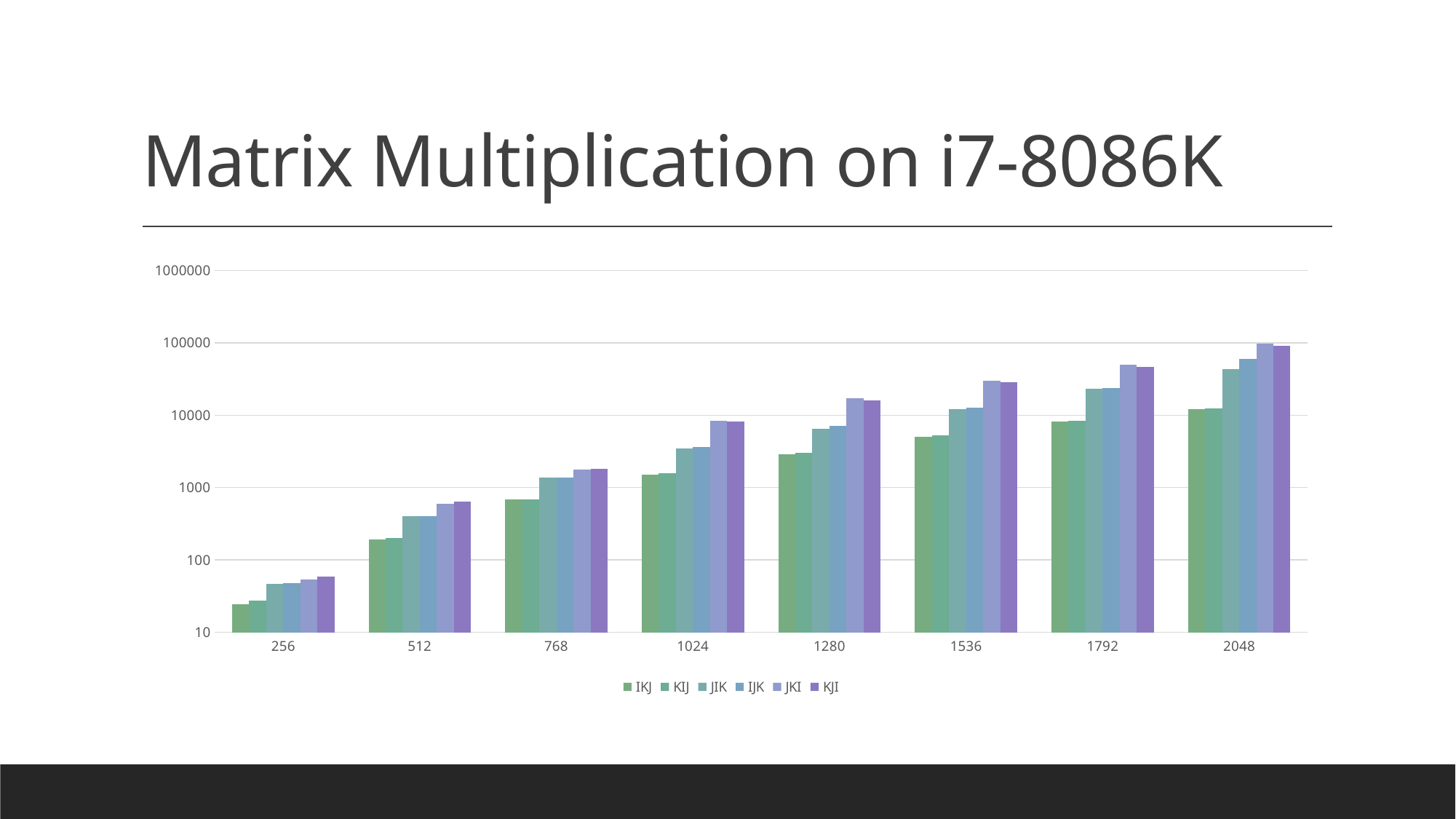
Do the values for the IKJ series rise or fall as the matrix size increases along the x axis? rise What kind of chart is shown on the slide? bar chart Is the value for JKI at matrix size 1536 greater or less than 10000? greater Is the value for IKJ at matrix size 256 greater or less than 100? less Which matrix size category has the highest bars overall? 2048 What is the title of the slide containing the chart? Matrix Multiplication on i7-8086K Is the value for IKJ at matrix size 2048 greater or less than 10000? greater Which series is listed first in the legend? IKJ At matrix size 2048, which is larger, the value for JKI or the value for IKJ? JKI Which matrix size category has the lowest bars overall? 256 How many matrix size categories are shown on the x axis? 8 How many series does the legend list? 6